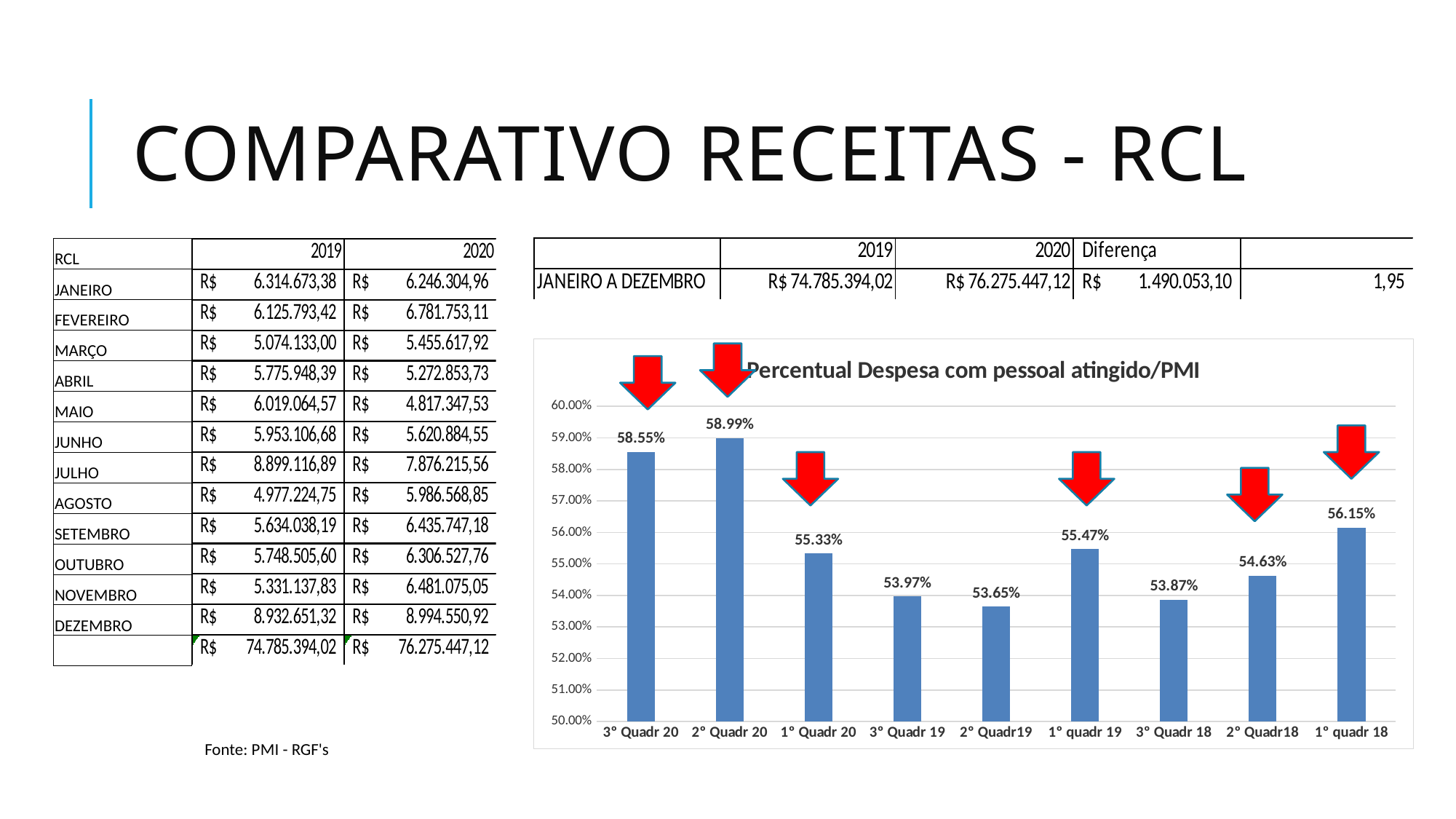
What is the value for 3° Quadr 19 in the chart? 53.97% Which is larger, the value for 1° Quadr 20 or the value for 2° Quadr18? 1° Quadr 20 Which category has the highest value in the chart? 2° Quadr 20 How many bars are shown in the chart? 9 What is the title of the chart? Percentual Despesa com pessoal atingido/PMI Which category has the lowest value in the chart? 2° Quadr19 Is the value for 3° Quadr 20 greater or less than 58.00%? greater What kind of chart is shown on the slide? bar chart What is the value for 2° Quadr 20 in the chart? 58.99% What is the value for 1° quadr 18 in the chart? 56.15% What is the difference between the values for 2° Quadr 20 and 3° Quadr 20? 0.44% What is the difference between the values for 1° quadr 18 and 1° quadr 19? 0.68%